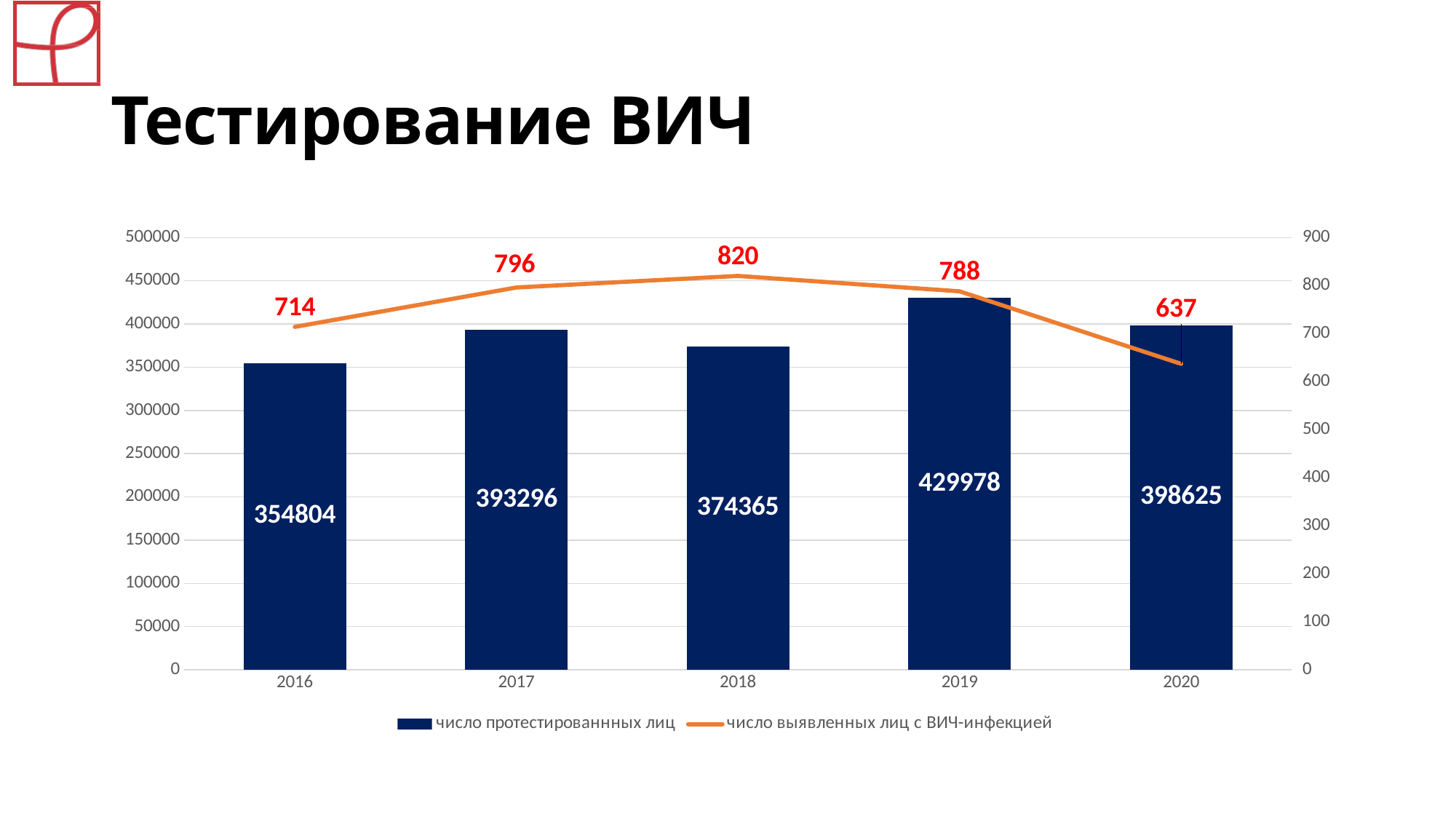
What is the number of tested persons (число протестированных лиц) in 2019? 429978 What is the number of persons identified with HIV infection (число выявленных лиц с ВИЧ-инфекцией) in 2018? 820 What kind of chart is shown on the slide? Combined bar and line chart How many series does the legend list? 2 What is the difference between the number of tested persons in 2019 and in 2018? 55613 What is the title of the slide? Тестирование ВИЧ Which year has more tested persons, 2017 or 2020? 2020 What is the number of tested persons in 2016? 354804 In which year is the number of tested persons highest? 2019 How many years are shown on the x axis? 5 In which year is the number of persons identified with HIV infection lowest? 2020 What is the difference between the number of persons identified with HIV infection in 2018 and in 2020? 183